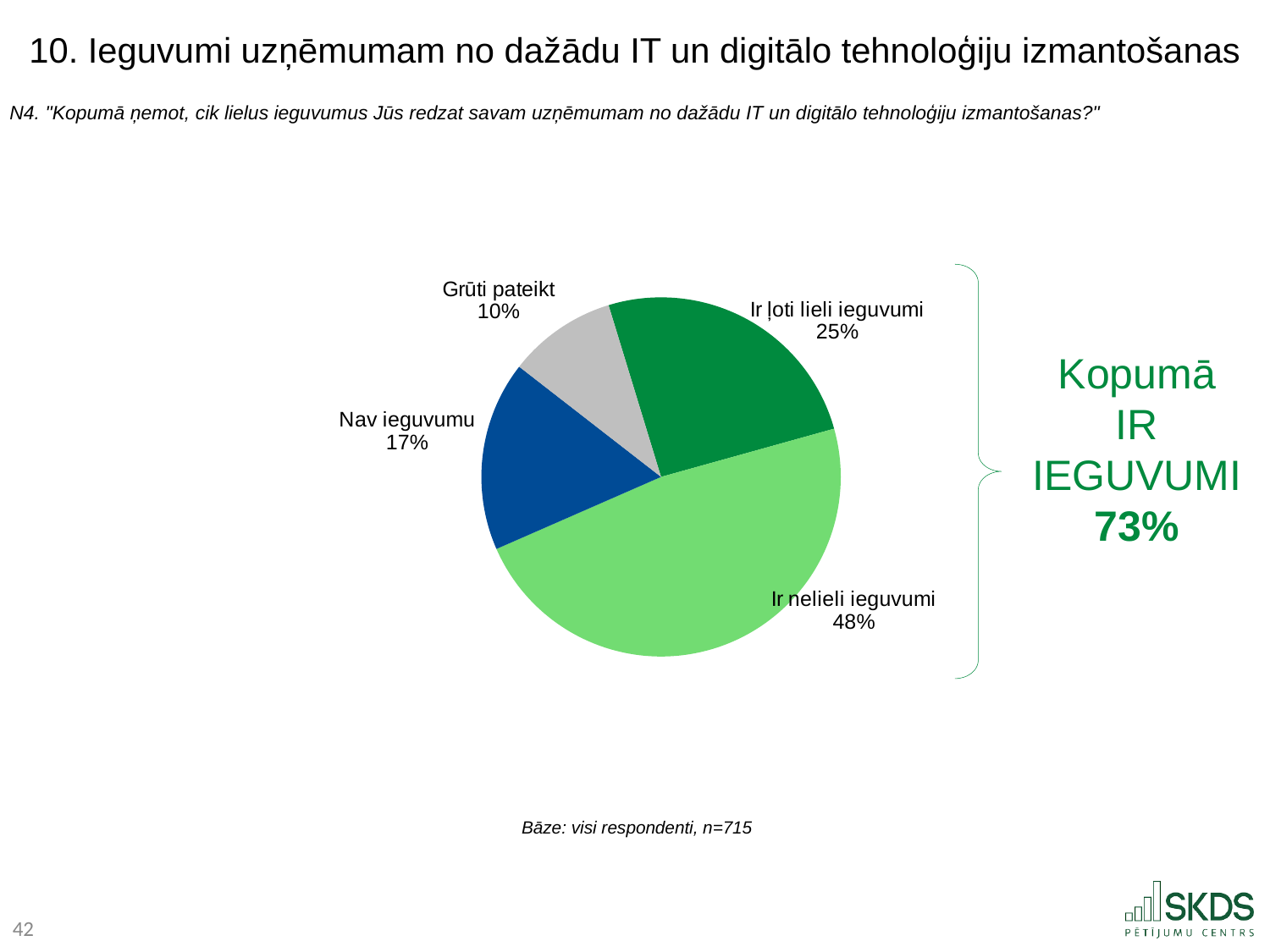
What percentage of respondents answered "Nav ieguvumu"? 17% What percentage of respondents answered "Ir ļoti lieli ieguvumi"? 25% Which is larger: the share for "Nav ieguvumu" or the share for "Grūti pateikt"? Nav ieguvumu What is the base (number of respondents) stated below the chart? n=715 What combined percentage is shown for "Kopumā IR IEGUVUMI"? 73% What kind of chart is shown on the slide? pie chart Which category has the largest share of the pie? Ir nelieli ieguvumi What is the difference in percentage points between "Ir nelieli ieguvumi" and "Ir ļoti lieli ieguvumi"? 23 percentage points How many slices does the pie chart have? 4 What percentage of respondents answered "Ir nelieli ieguvumi"? 48% Which category has the smallest share of the pie? Grūti pateikt What percentage of respondents answered "Grūti pateikt"? 10%